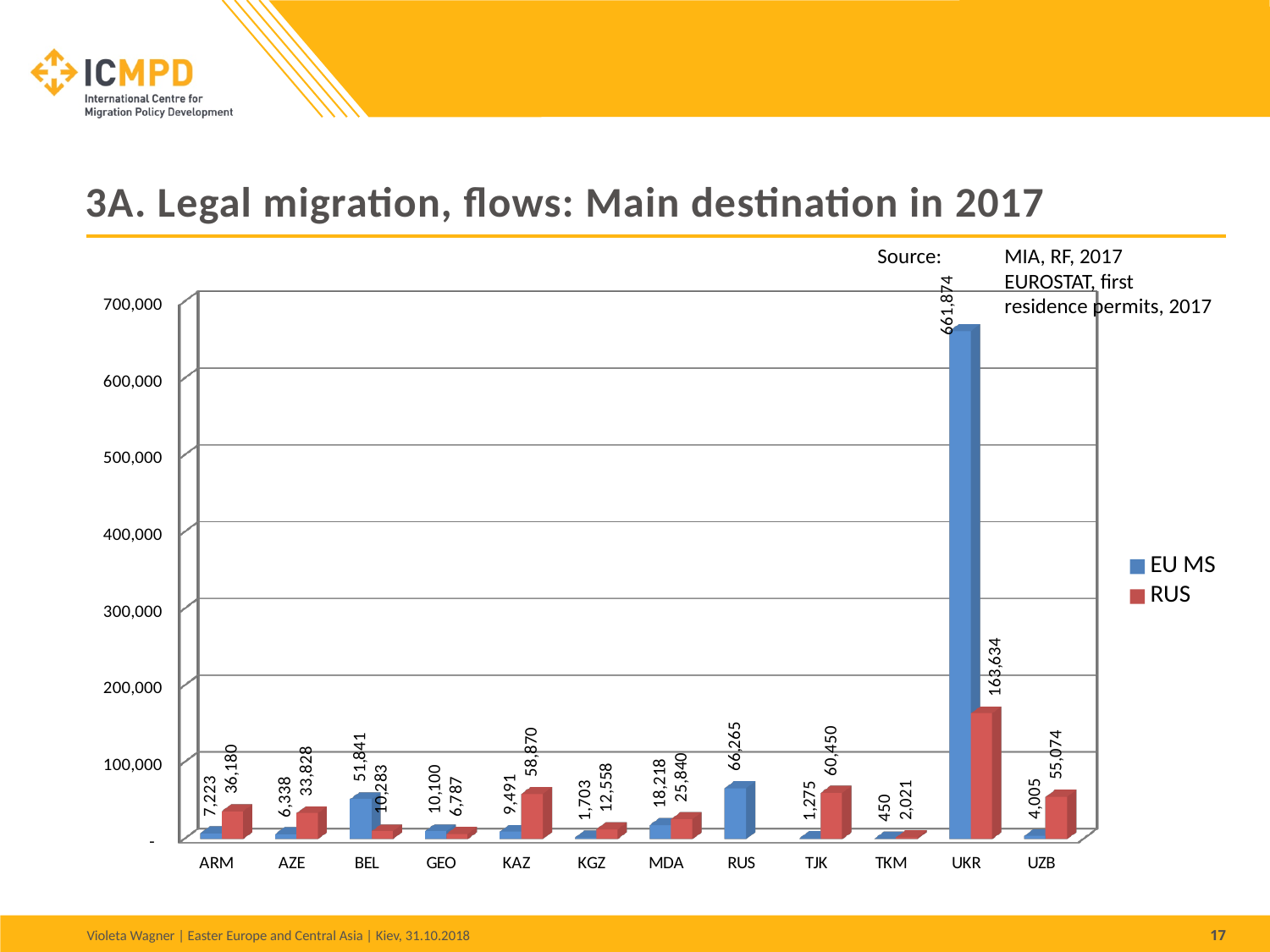
What is the EU MS value for BEL? 51,841 For ARM, which is larger: the EU MS value or the RUS value? RUS Is the RUS value for UKR greater or less than 200,000? less What is the EU MS value for UKR? 661,874 What is the RUS value for TKM? 2,021 What kind of chart is shown on the slide? bar chart How many series does the legend list? 2 Which category has the lowest EU MS value? TKM Which category has the highest EU MS value? UKR How many categories are shown on the x axis? 12 What is the difference between the EU MS and RUS values for UKR? 498,240 What is the RUS value for KAZ? 58,870